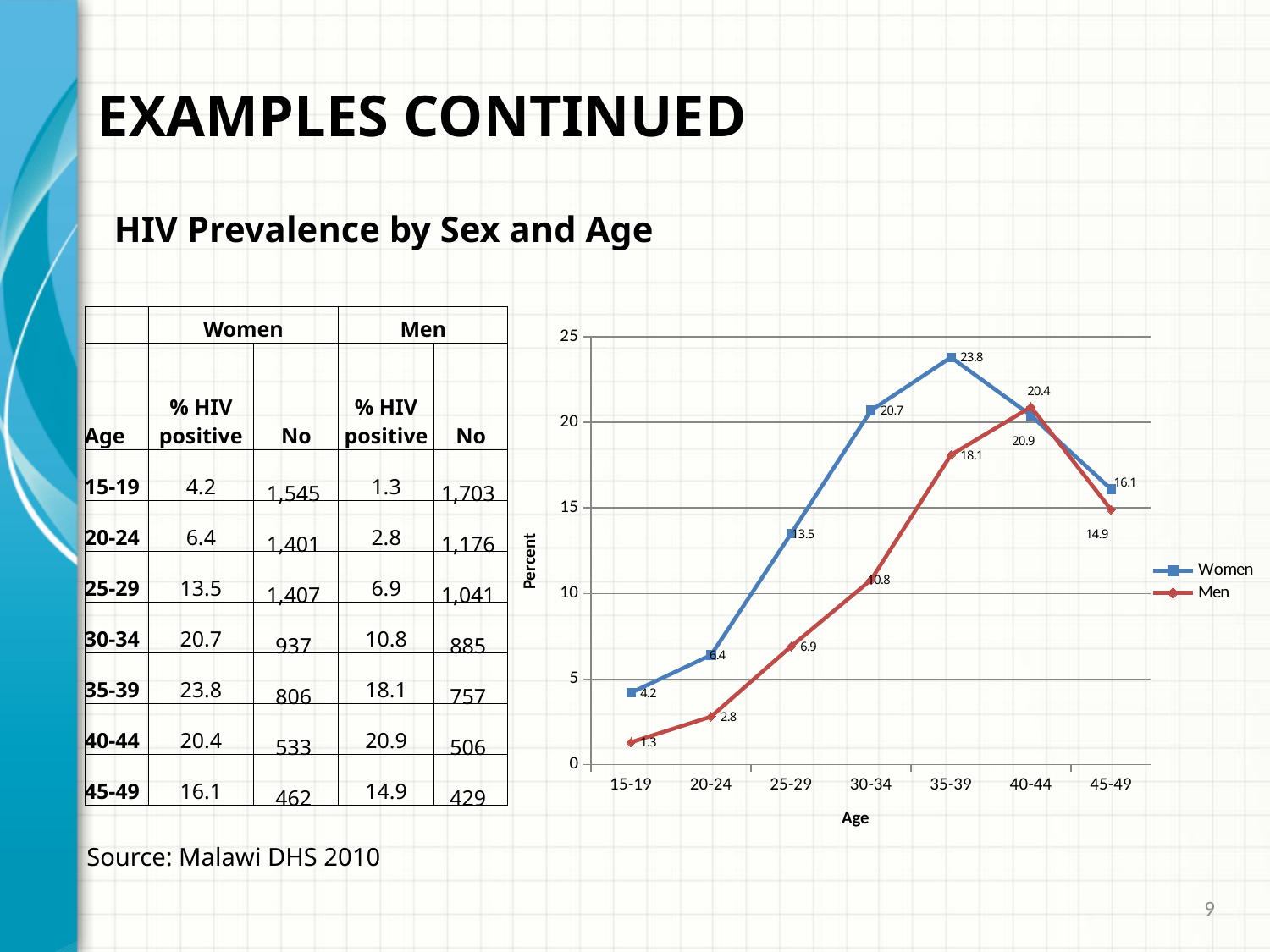
In the 40-44 age group, which series has the larger value, Women or Men? Men What is the HIV prevalence value for Women in the 35-39 age group? 23.8 What is the difference between the Women and Men values in the 30-34 age group? 9.9 How many age groups are shown on the x axis of the chart? 7 How many series does the chart legend list? 2 What kind of chart is shown on the slide? line chart Which age group has the lowest value for Men? 15-19 What is the title of the chart's vertical axis? Percent Is the value for Men in the 25-29 age group greater or less than 10? less Do the values for Men rise or fall from the 15-19 age group to the 40-44 age group? rise Which age group has the highest value for Women? 35-39 What is the HIV prevalence value for Men in the 40-44 age group? 20.9